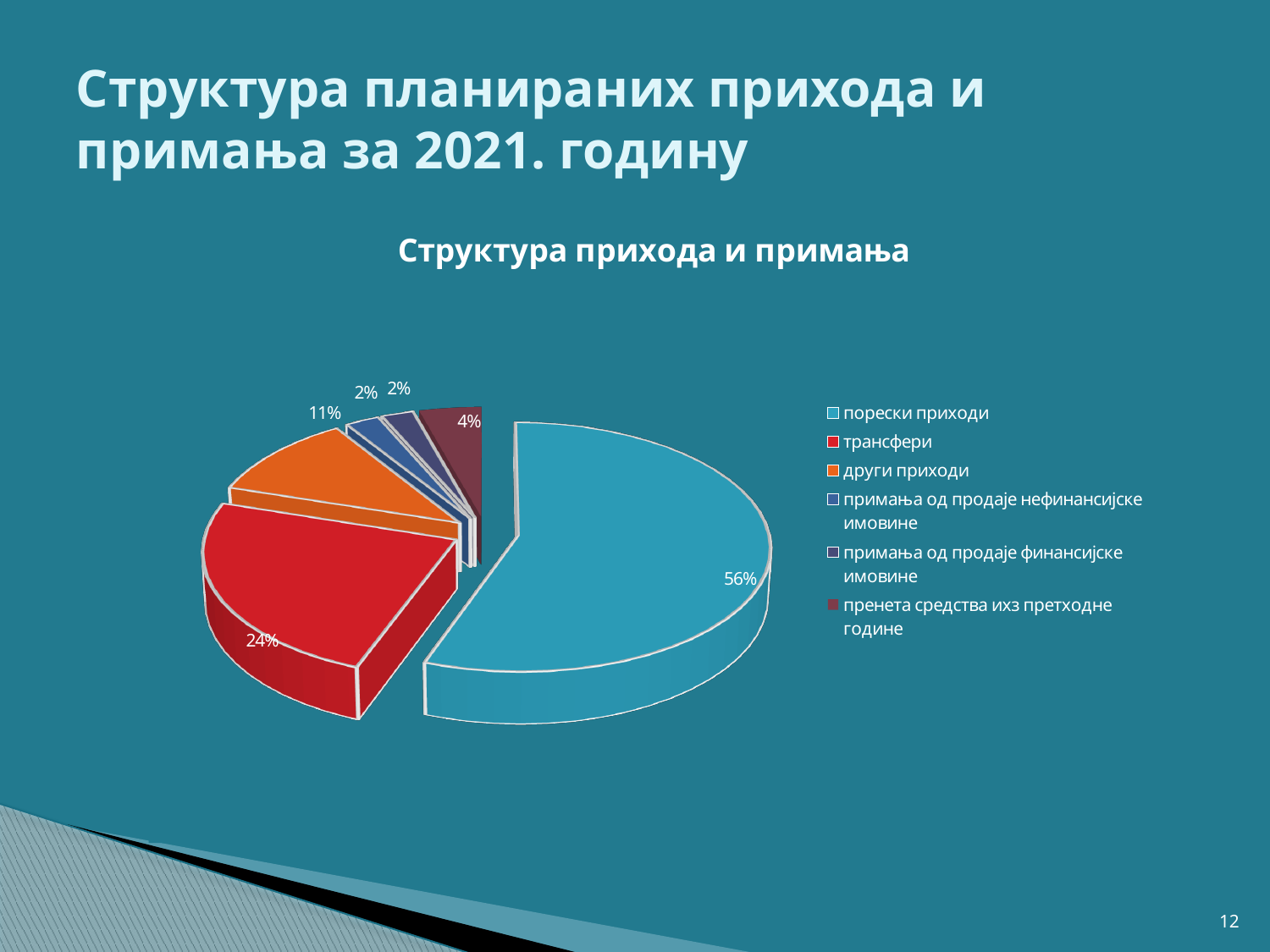
What share of the pie is други приходи? 11% What colour is the slice for трансфери? Red What share of the pie is пренета средства ихз претходне године? 4% What is the title of the chart? Структура прихода и примања What is the difference between the shares of порески приходи and трансфери? 32% What share of the pie is трансфери? 24% What share of the pie is порески приходи? 56% Which category has the largest slice of the pie? порески приходи Which is larger, the share of други приходи or the share of пренета средства ихз претходне године? други приходи How many categories does the legend list? 6 What share of the pie is примања од продаје нефинансијске имовине? 2% What kind of chart is shown on the slide? Pie chart